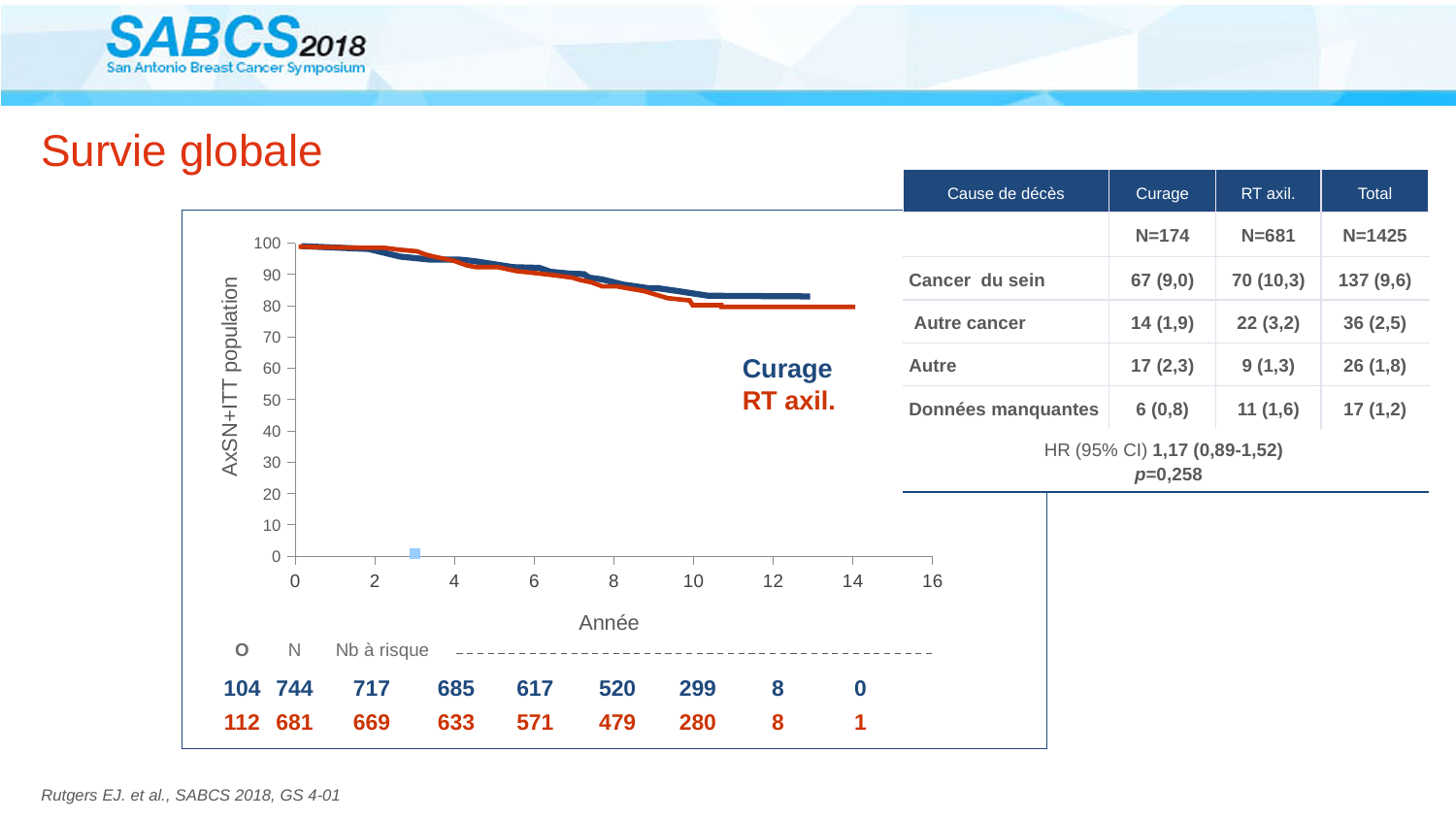
Do the survival curves rise or fall as the years increase along the x axis? fall In the number-at-risk table below the chart, what is the number at risk for Curage at year 4? 685 How many series does the chart's legend list? 2 Which colour is used for the Curage series in the chart? blue Is the value of the Curage curve at year 12 greater or less than 80? greater At year 8, which group has more patients at risk in the table below the chart, Curage or RT axil.? Curage In the number-at-risk table below the chart, what is the N for the Curage group? 744 In the number-at-risk table below the chart, what is the difference between the N of the Curage group and the N of the RT axil. group? 63 Is the value of the RT axil. curve at year 12 greater or less than 90? less What is the title of the x axis of the chart? Année What kind of chart is shown on the slide? line chart In the number-at-risk table below the chart, what is the number at risk for RT axil. at year 10? 280